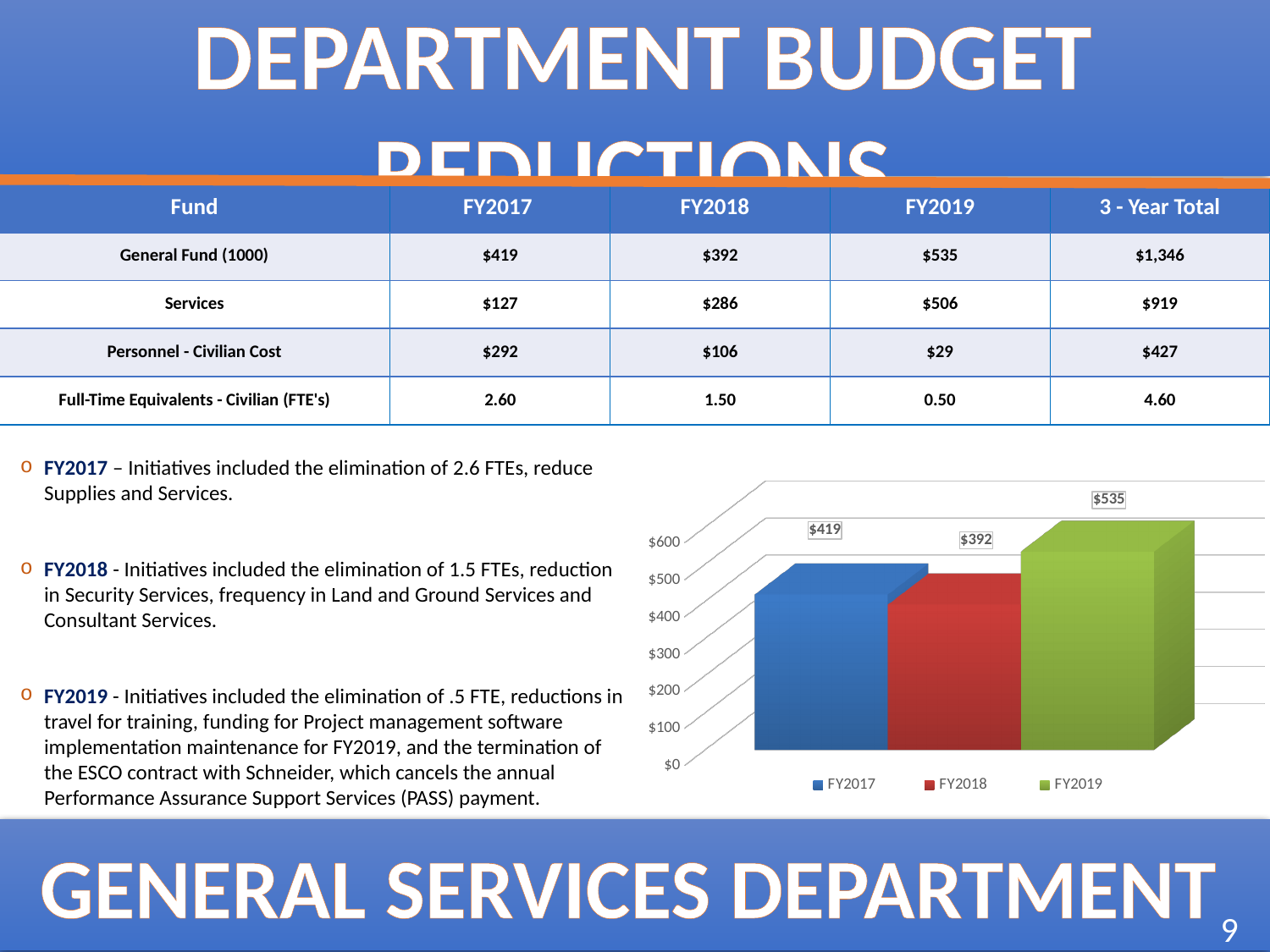
Is the value for FY2019 in the chart greater or less than $500? greater What kind of chart is shown on the slide? bar chart What colour is the FY2018 bar in the chart? red What is the difference between the FY2019 and FY2018 values in the chart? $143 Which fiscal year has the highest value in the chart? FY2019 What value does the chart show for FY2018? $392 What value does the chart show for FY2017? $419 What value does the chart show for FY2019? $535 How many series does the chart legend list? 3 What is the difference between the FY2017 and FY2018 values in the chart? $27 Which is larger in the chart, the value for FY2017 or the value for FY2019? FY2019 Which fiscal year has the lowest value in the chart? FY2018